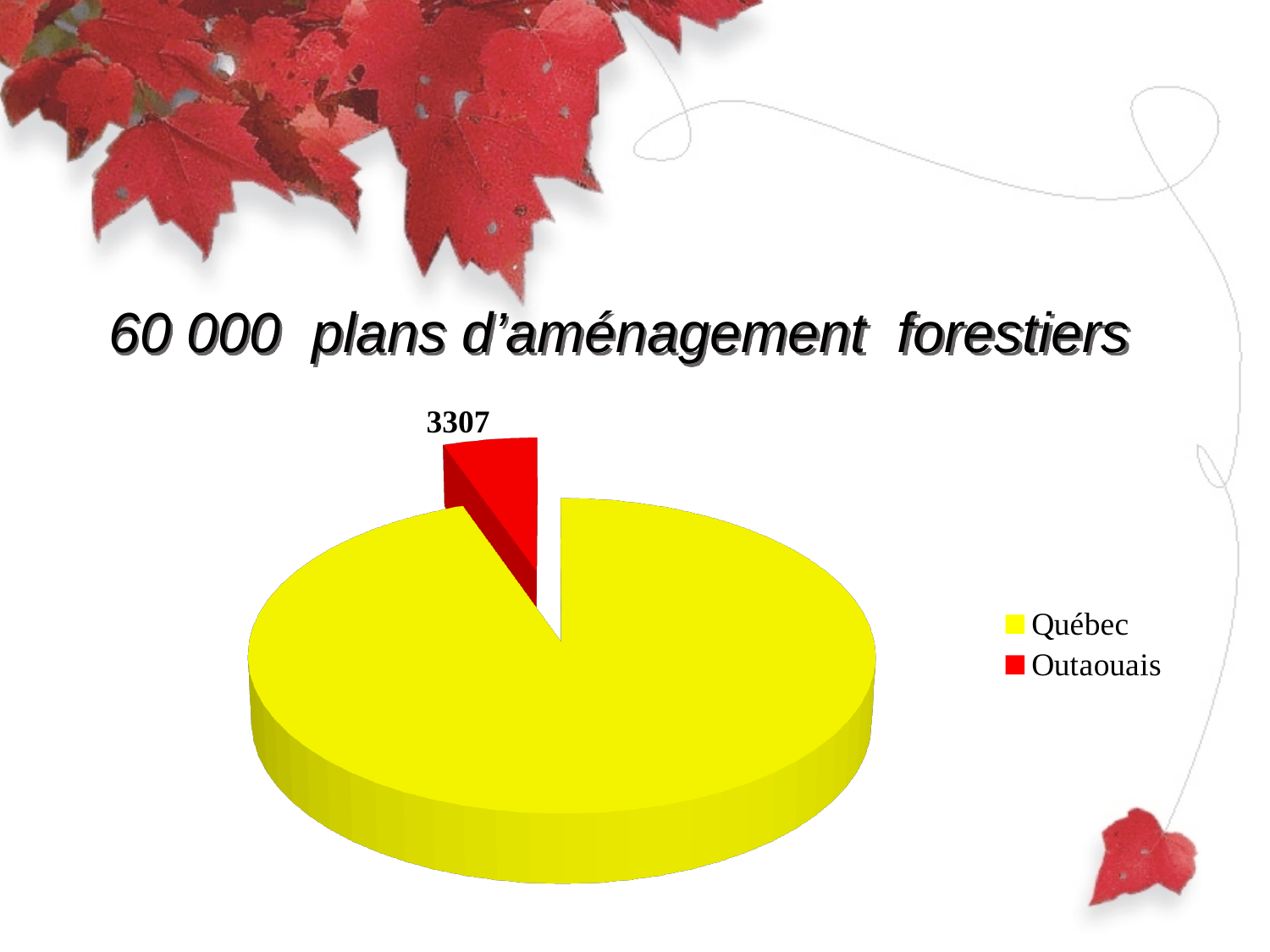
What kind of chart is shown on the slide? Pie chart What colour is the Outaouais slice in the pie chart? Red Which category has the largest slice of the pie chart? Québec Which category has the smallest slice of the pie chart? Outaouais What value is shown for the Outaouais slice of the pie chart? 3307 How many slices does the pie chart have? 2 How many entries does the legend list? 2 What is the title shown above the chart? 60 000 plans d'aménagement forestiers Which slice is larger, Québec or Outaouais? Québec